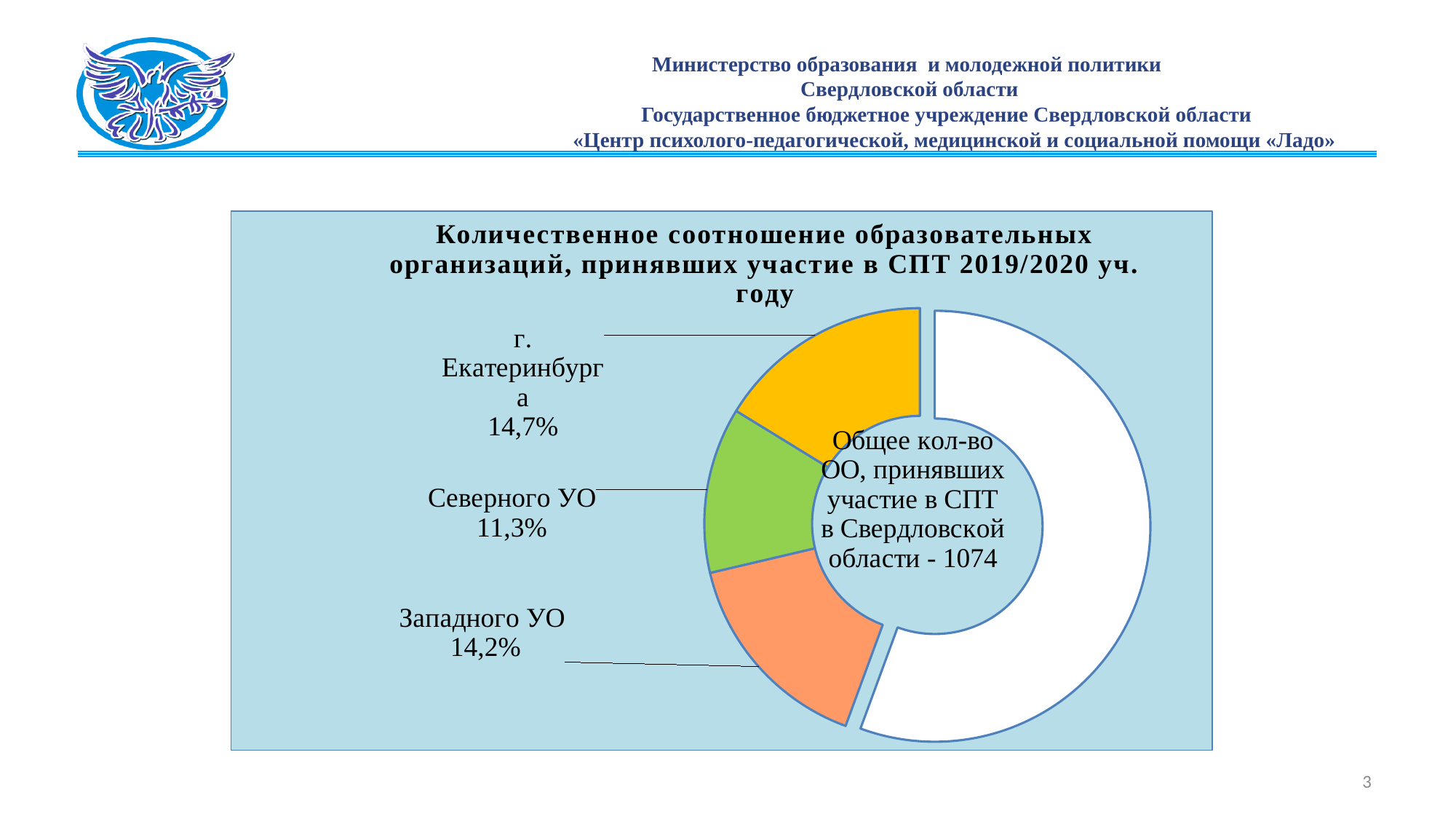
What colour is the slice for Северного УО? Green Which share is larger: Северного УО or Западного УО? Западного УО What percentage share is shown for Северного УО? 11,3% What percentage share is shown for г. Екатеринбурга? 14,7% What is the difference in percentage points between the shares of г. Екатеринбурга and Северного УО? 3,4% What total number of educational organisations is stated in the centre of the chart? 1074 What is the difference in percentage points between the shares of Западного УО and Северного УО? 2,9% How many slices of the chart have a percentage label? 3 What percentage share is shown for Западного УО? 14,2% What kind of chart is shown on the slide? Doughnut (pie) chart Which of the labelled slices has the smallest share? Северного УО